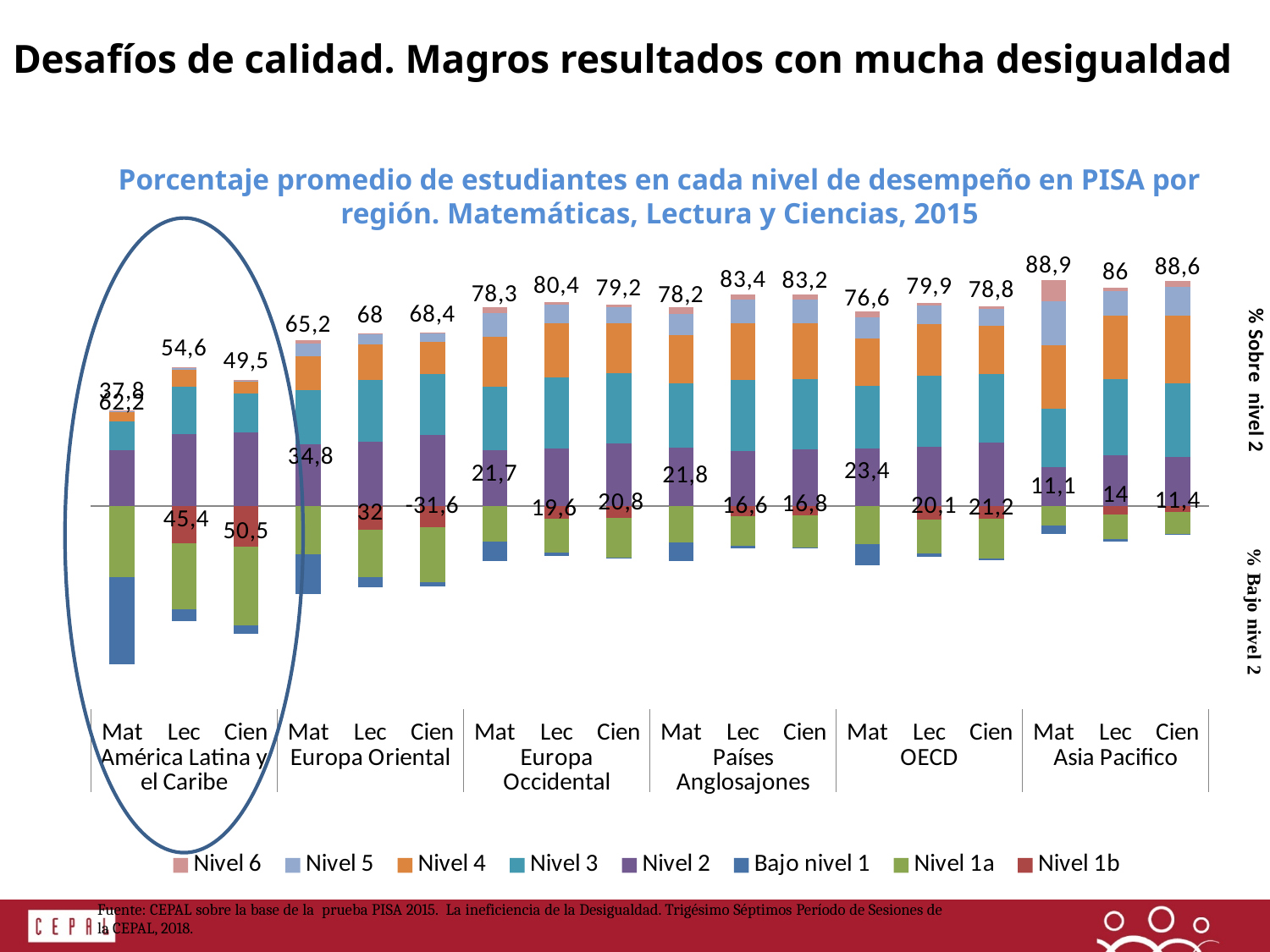
How many regions are shown on the x axis? 6 What is the percentage above level 2 for Lec in Asia Pacifico? 86 What is the percentage below level 2 for Mat in OECD? 23,4 What type of chart is shown on the slide? stacked bar chart How many series does the legend list? 8 Which region and subject has the highest percentage above level 2? Asia Pacifico, Mat (88,9) Which region and subject has the lowest percentage above level 2? América Latina y el Caribe, Mat (37,8) What is the percentage above level 2 for Cien in Europa Oriental? 68,4 Which has a larger percentage above level 2: Lec in Europa Oriental or Lec in OECD? Lec in OECD What is the percentage below level 2 for Lec in América Latina y el Caribe? 45,4 Which region is circled on the chart? América Latina y el Caribe What is the difference between the above-level-2 percentage for Lec in Países Anglosajones and Lec in OECD? 3,5